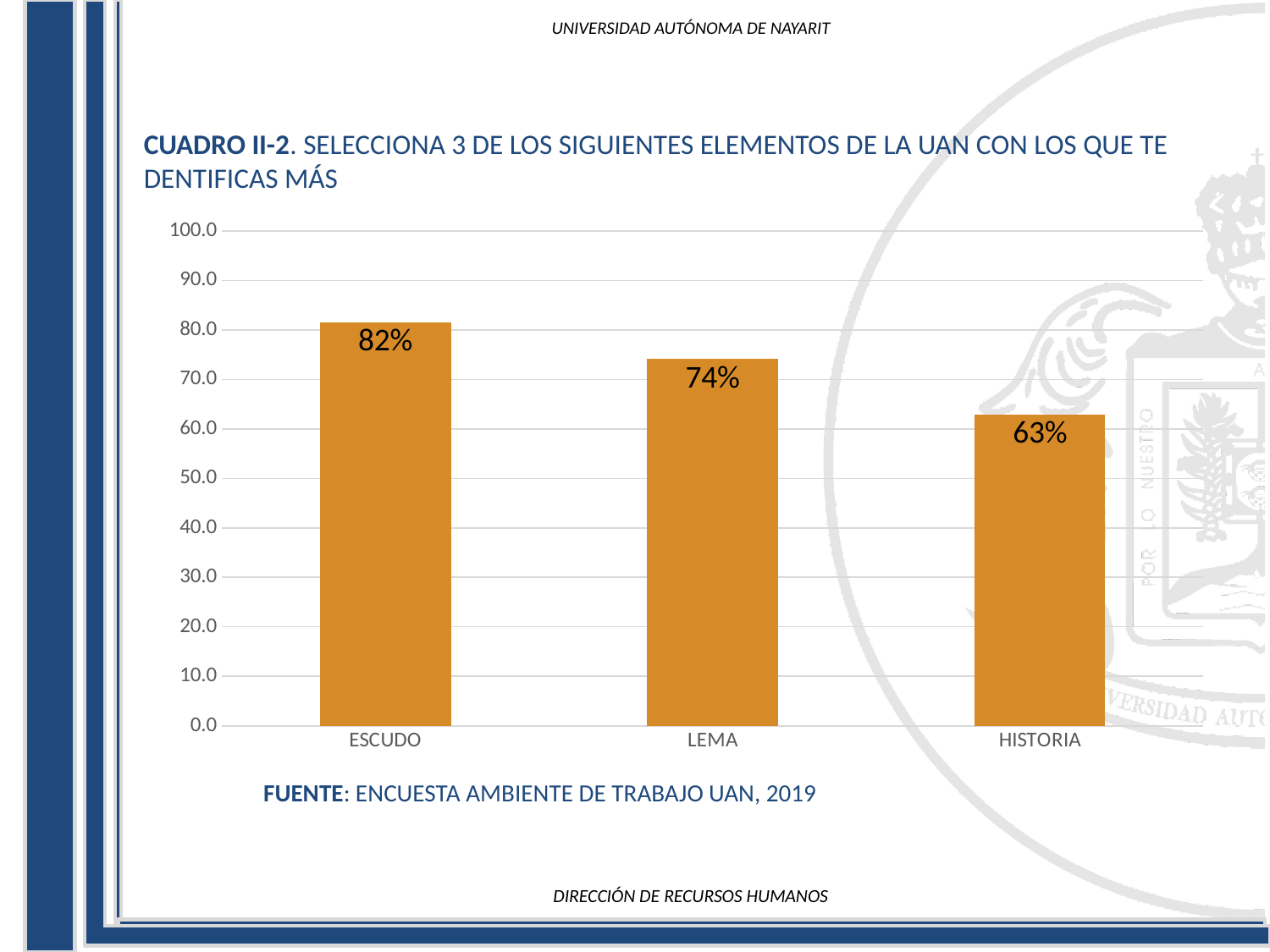
Which category has the highest value? ESCUDO Which category has the lowest value? HISTORIA What is the value for LEMA? 74% What is the value for ESCUDO? 82% What kind of chart is shown on the slide? Bar chart What is the value for HISTORIA? 63% What is the difference between the values for ESCUDO and HISTORIA? 19% What is the difference between the values for LEMA and HISTORIA? 11% Do the values rise or fall from ESCUDO to HISTORIA along the x axis? Fall How many categories are shown in the chart? 3 Is the value for LEMA greater or less than 70.0? greater Which is larger, the value for LEMA or the value for HISTORIA? LEMA